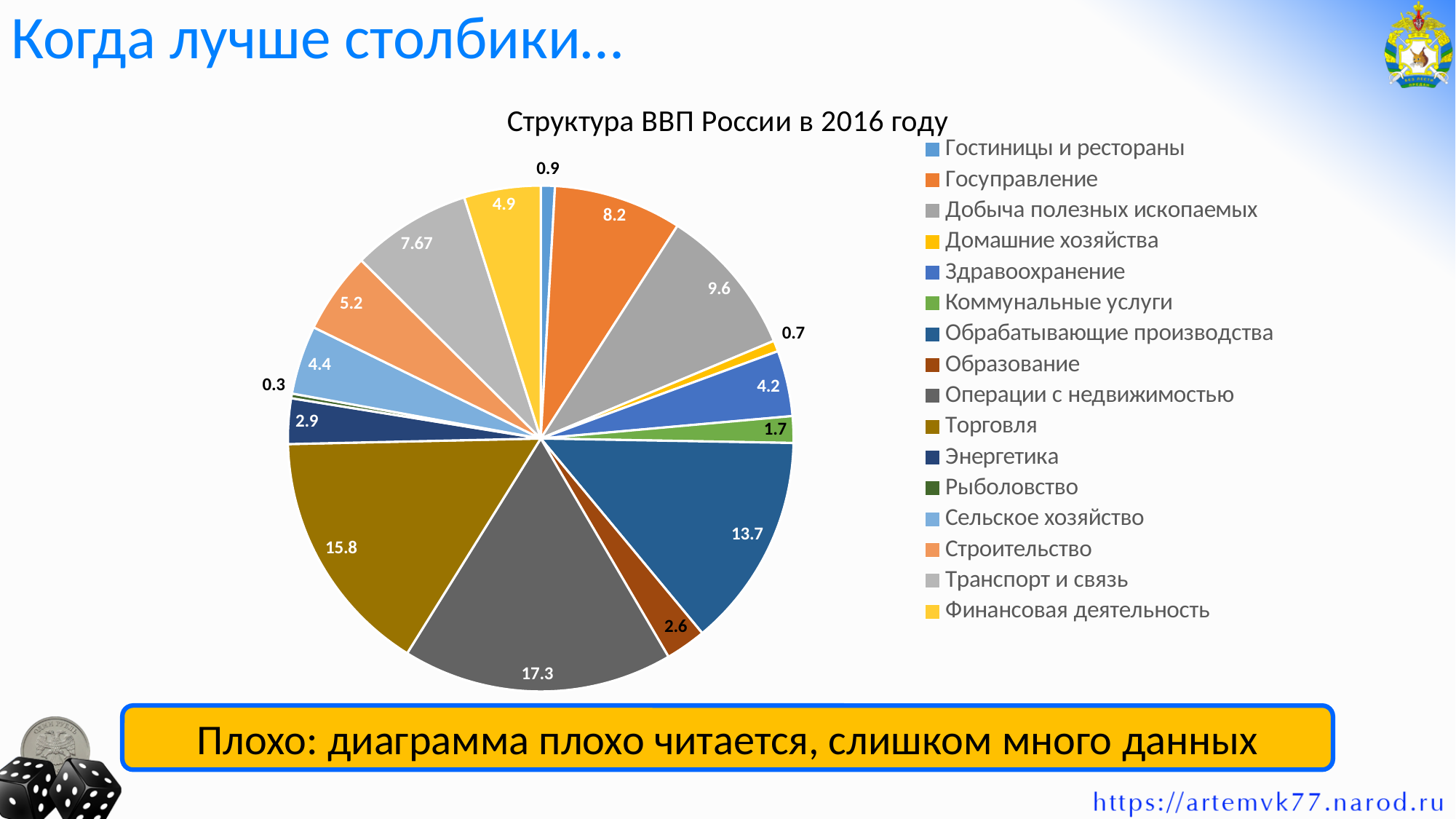
What is the value shown for Транспорт и связь? 7.67 Which category has the largest slice of the pie? Операции с недвижимостью What is the title of the chart? Структура ВВП России в 2016 году What is the difference between the values for Обрабатывающие производства and Образование? 11.1 What is the value shown for Торговля? 15.8 What type of chart is shown on the slide? pie chart What is the difference between the values for Операции с недвижимостью and Торговля? 1.5 Which is larger, the value for Госуправление or the value for Добыча полезных ископаемых? Добыча полезных ископаемых What is the value shown for Операции с недвижимостью? 17.3 How many categories does the legend of the pie chart list? 16 What is the value shown for Рыболовство? 0.3 Which category has the smallest slice of the pie? Рыболовство